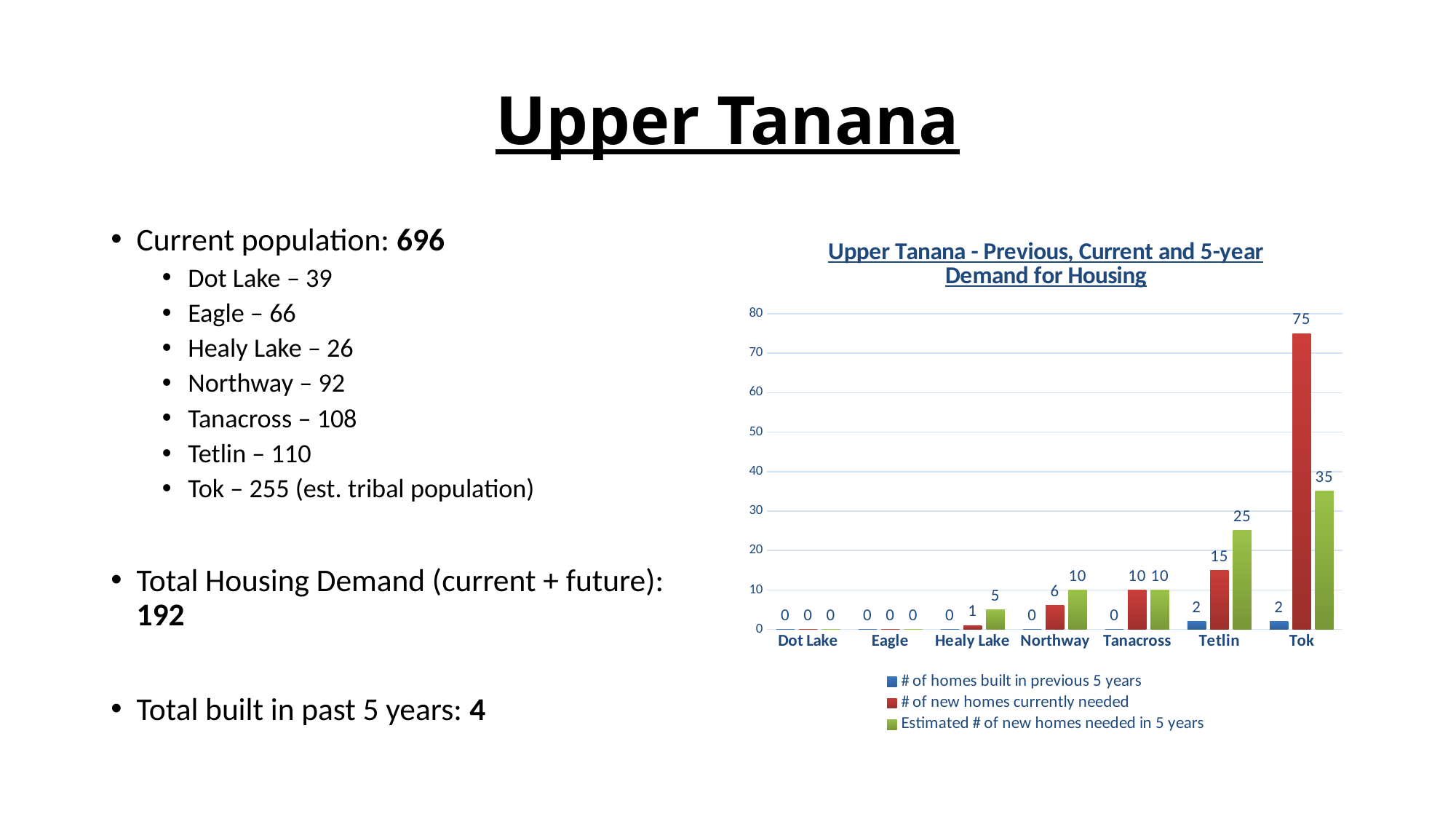
How many communities are shown on the x axis of the chart? 7 Is the number of new homes currently needed in Tok greater or less than 70? greater What is the title of the chart? Upper Tanana - Previous, Current and 5-year Demand for Housing Which is larger: the number of new homes currently needed in Northway or in Tanacross? Tanacross How many series does the legend list? 3 What is the number of new homes currently needed in Northway? 6 What is the estimated number of new homes needed in 5 years for Tetlin? 25 How many homes were built in the previous 5 years in Healy Lake? 0 What is the difference between the estimated number of new homes needed in 5 years for Tok and for Tetlin? 10 What is the number of new homes currently needed in Tok? 75 What kind of chart is shown on the slide? bar chart Which community has the highest number of new homes currently needed? Tok